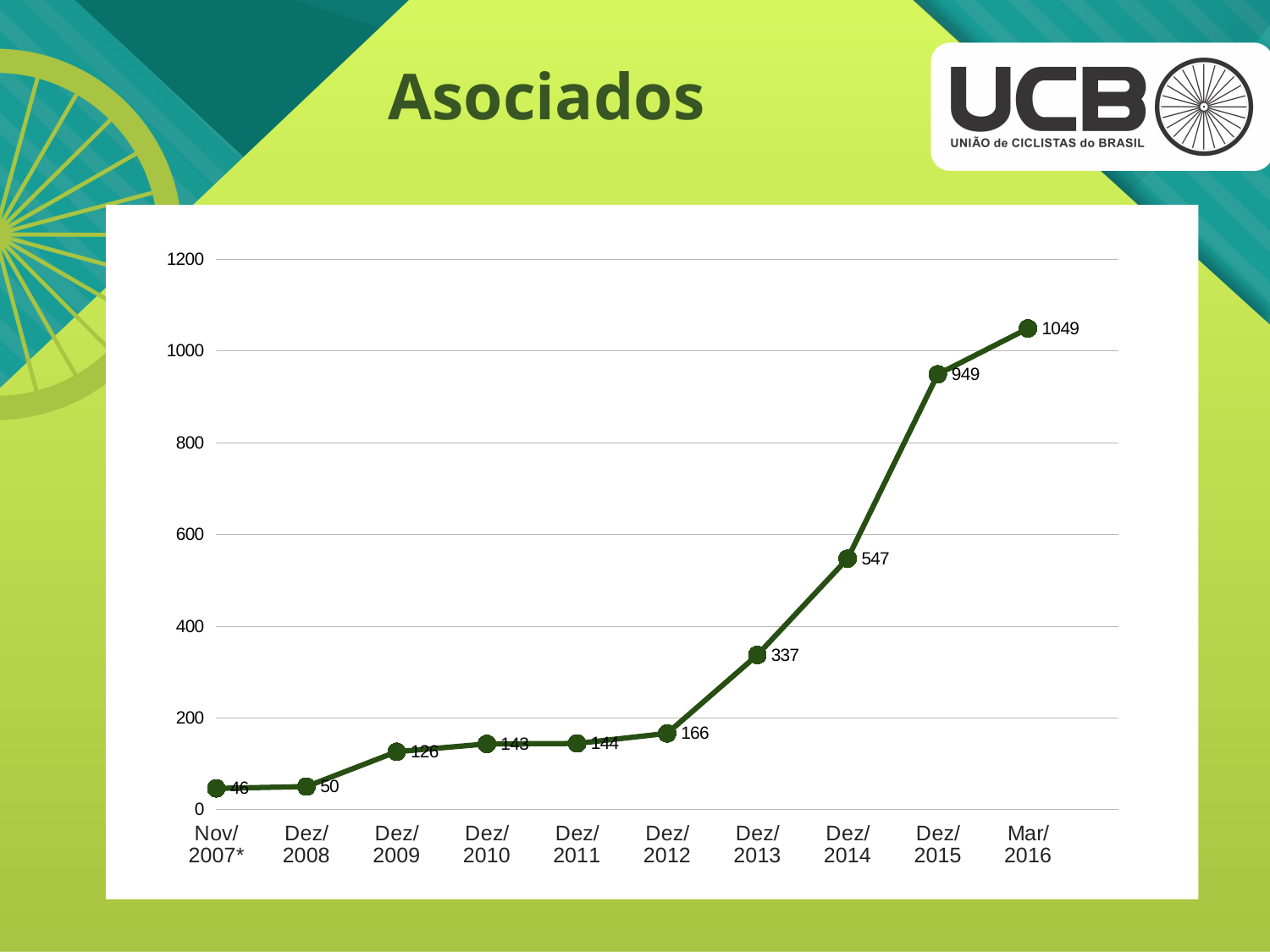
Which is larger, the value for Dez/2013 or the value for Dez/2012? Dez/2013 How many data points are plotted on the chart? 10 What is the title of the slide containing the chart? Asociados What is the value for Nov/2007*? 46 What is the value for Mar/2016? 1049 Which category has the highest value? Mar/2016 What is the value for Dez/2014? 547 What is the difference between the values for Dez/2015 and Dez/2014? 402 What kind of chart is shown on the slide? line chart Do the values rise or fall from Nov/2007* to Mar/2016? rise Which category has the lowest value? Nov/2007* What is the value for Dez/2012? 166